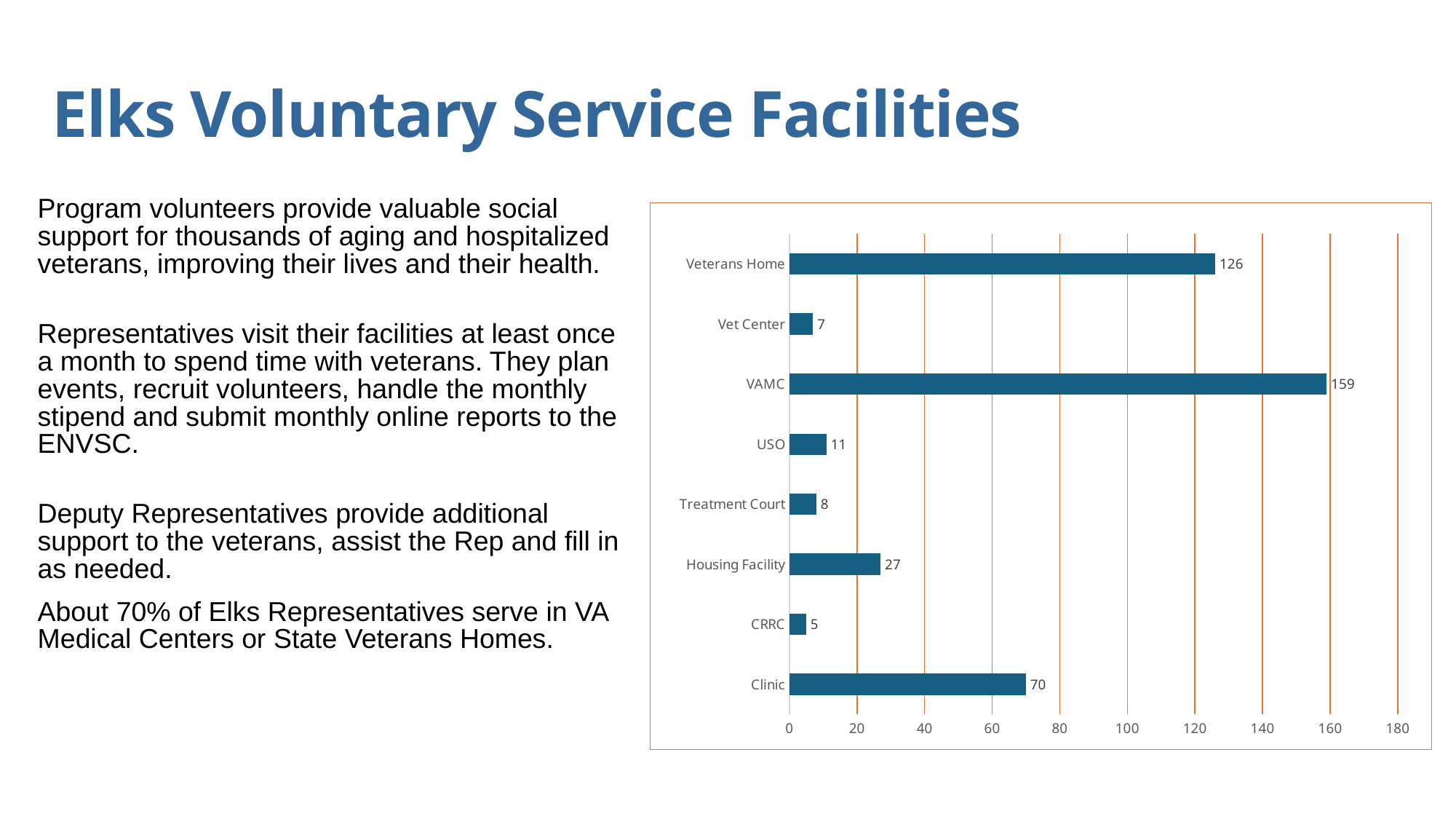
Is the value for Clinic greater or less than 60? greater What kind of chart is shown on the slide? Bar chart What is the value for Housing Facility? 27 Which is larger, the value for USO or the value for Treatment Court? USO What is the value for VAMC? 159 What is the value for Veterans Home? 126 Which category has the lowest value? CRRC How many categories are shown in the chart? 8 Which category has the highest value? VAMC What is the difference between the values for VAMC and Veterans Home? 33 What is the value for Vet Center? 7 What is the value for Clinic? 70